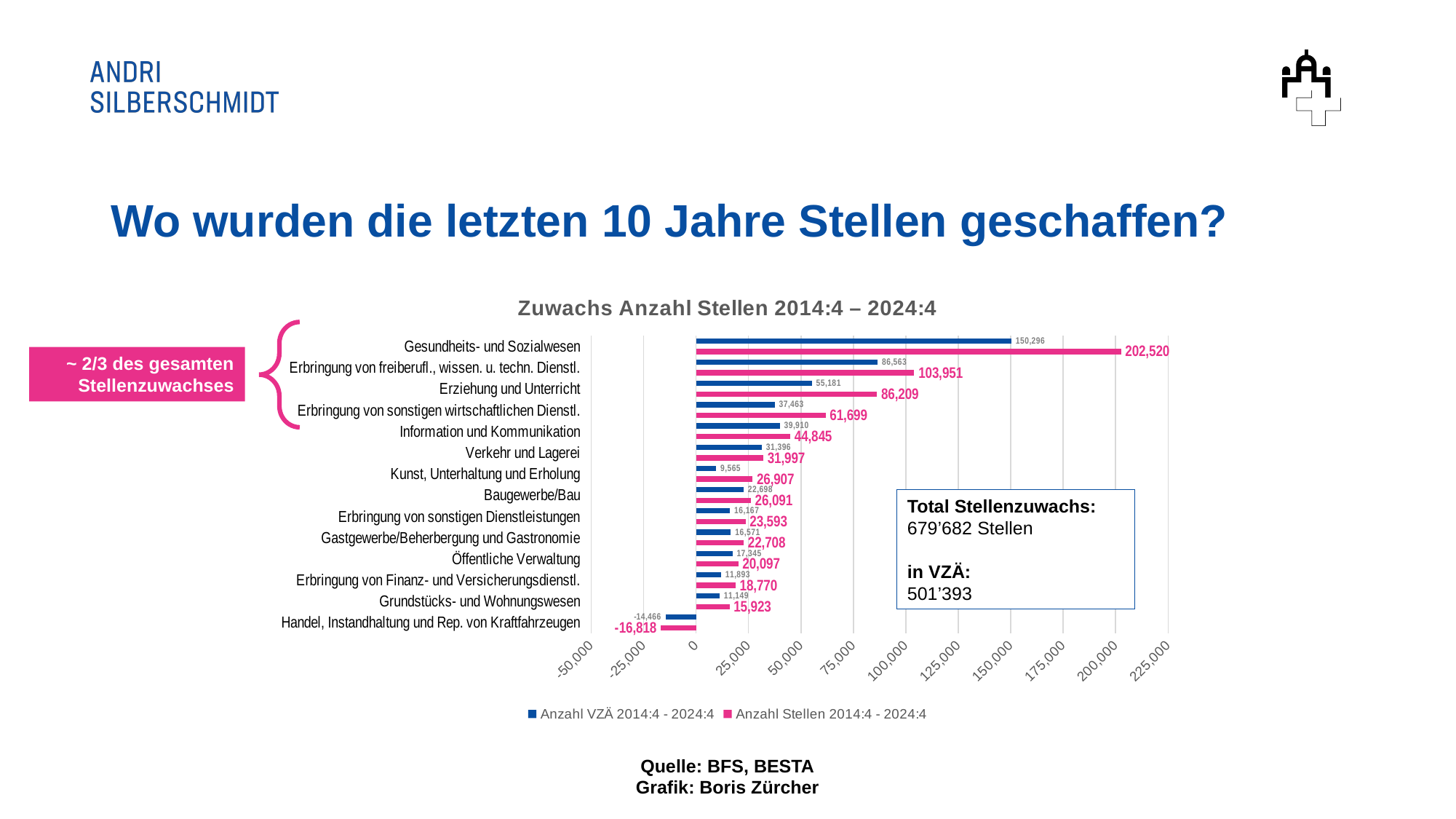
Which category has the highest value for Anzahl Stellen 2014:4 - 2024:4? Gesundheits- und Sozialwesen Which is larger for Kunst, Unterhaltung und Erholung: Anzahl VZÄ 2014:4 - 2024:4 or Anzahl Stellen 2014:4 - 2024:4? Anzahl Stellen 2014:4 - 2024:4 Is the Anzahl Stellen 2014:4 - 2024:4 value for Erbringung von freiberufl., wissen. u. techn. Dienstl. greater or less than 100,000? greater What is the title of the chart? Zuwachs Anzahl Stellen 2014:4 – 2024:4 What is the value of Anzahl Stellen 2014:4 - 2024:4 for Handel, Instandhaltung und Rep. von Kraftfahrzeugen? -16,818 Which category has the lowest value for Anzahl VZÄ 2014:4 - 2024:4? Handel, Instandhaltung und Rep. von Kraftfahrzeugen What is the value of Anzahl VZÄ 2014:4 - 2024:4 for Erziehung und Unterricht? 55,181 What is the value of Anzahl Stellen 2014:4 - 2024:4 for Gesundheits- und Sozialwesen? 202,520 How many series does the legend list? 2 What is the difference between Anzahl Stellen and Anzahl VZÄ for Gesundheits- und Sozialwesen? 52,224 How many categories are shown in the chart? 14 What kind of chart is shown on the slide? Bar chart